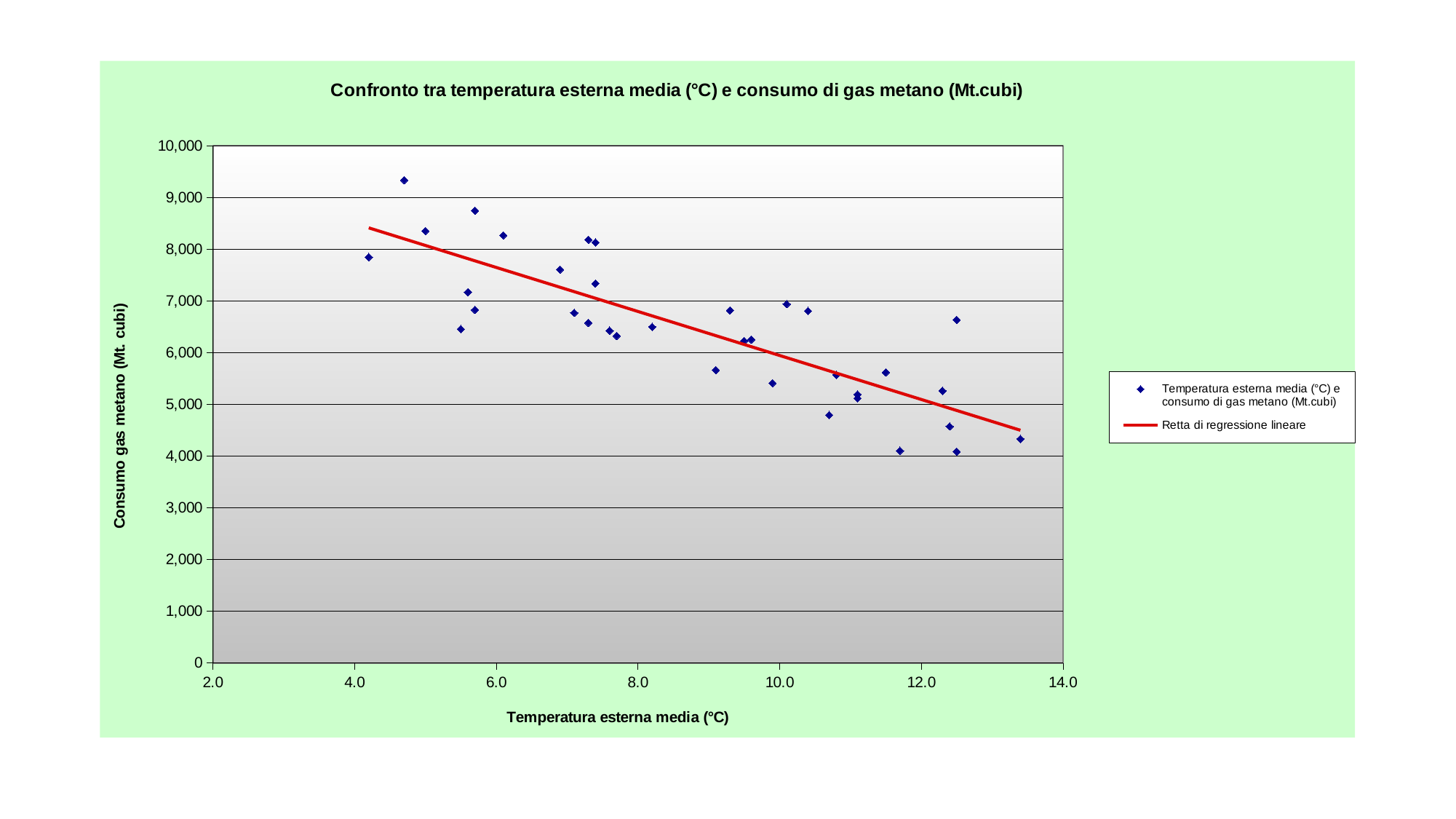
Is the value of the regression line at 12.0 °C greater or less than 6,000? less Is the gas consumption of the point plotted at the lowest temperature (about 4.2 °C) greater or less than 7,000? greater How many series does the legend list? 2 Does the regression line slope upward or downward from left to right? Downward Is the value of the regression line at 6.0 °C greater or less than 7,000? greater As the temperature on the x axis increases, does the gas consumption generally rise or fall? Fall What is the maximum value shown on the vertical axis? 10,000 What is the title of the chart? Confronto tra temperatura esterna media (°C) e consumo di gas metano (Mt.cubi) What kind of chart is shown on the slide? Scatter chart What is the label of the vertical axis? Consumo gas metano (Mt. cubi)